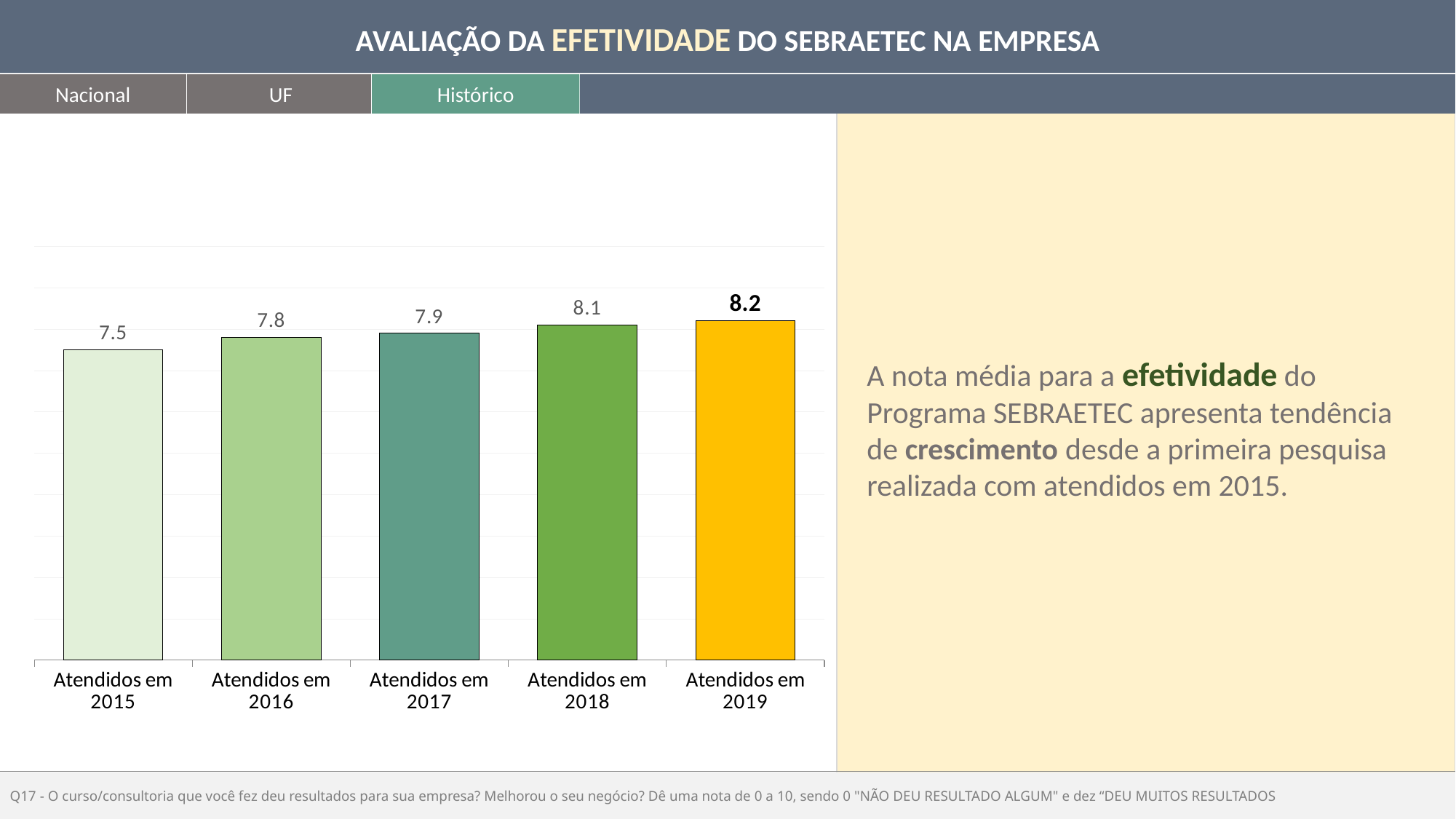
What colour is the bar for Atendidos em 2019? yellow/orange What is the value for Atendidos em 2017? 7.9 What is the value for Atendidos em 2019? 8.2 What is the difference between the values for Atendidos em 2019 and Atendidos em 2015? 0.7 Do the values rise or fall from Atendidos em 2015 to Atendidos em 2019? rise Which category has the lowest value? Atendidos em 2015 What kind of chart is shown on the slide? bar chart Which category has the highest value? Atendidos em 2019 How many categories are shown in the chart? 5 Which is larger, the value for Atendidos em 2016 or the value for Atendidos em 2018? Atendidos em 2018 What is the value for Atendidos em 2015? 7.5 What is the difference between the values for Atendidos em 2018 and Atendidos em 2016? 0.3